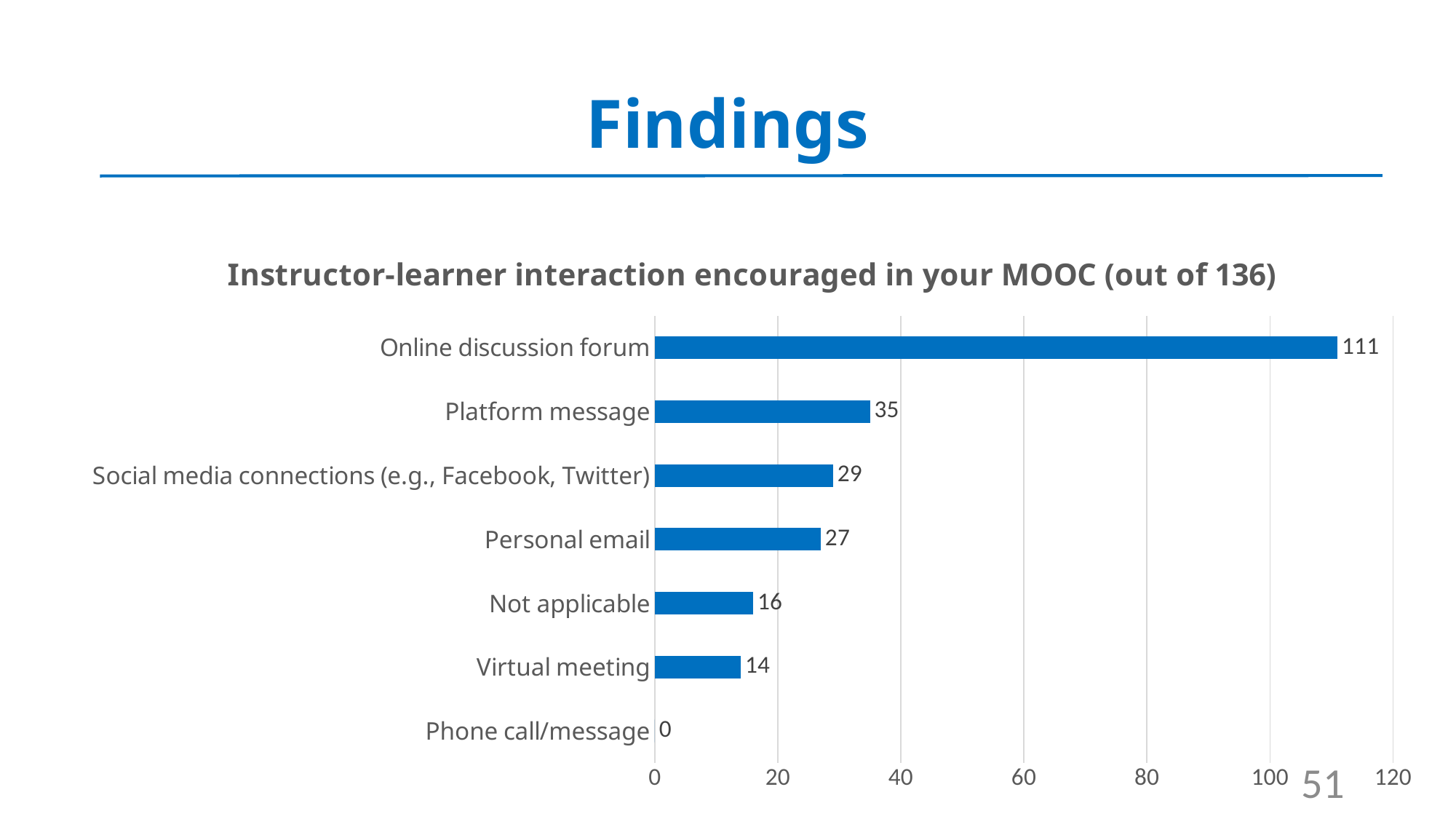
What is the value for Online discussion forum? 111 Which category has the highest value? Online discussion forum How many categories are shown in the chart? 7 What is the value for Platform message? 35 What is the value for Phone call/message? 0 Which category has the lowest value? Phone call/message What is the difference between the values for Not applicable and Virtual meeting? 2 What kind of chart is shown on the slide? Bar chart What is the title of the chart? Instructor-learner interaction encouraged in your MOOC (out of 136) What is the value for Social media connections (e.g., Facebook, Twitter)? 29 Which is larger, the value for Personal email or the value for Virtual meeting? Personal email What is the difference between the values for Online discussion forum and Platform message? 76